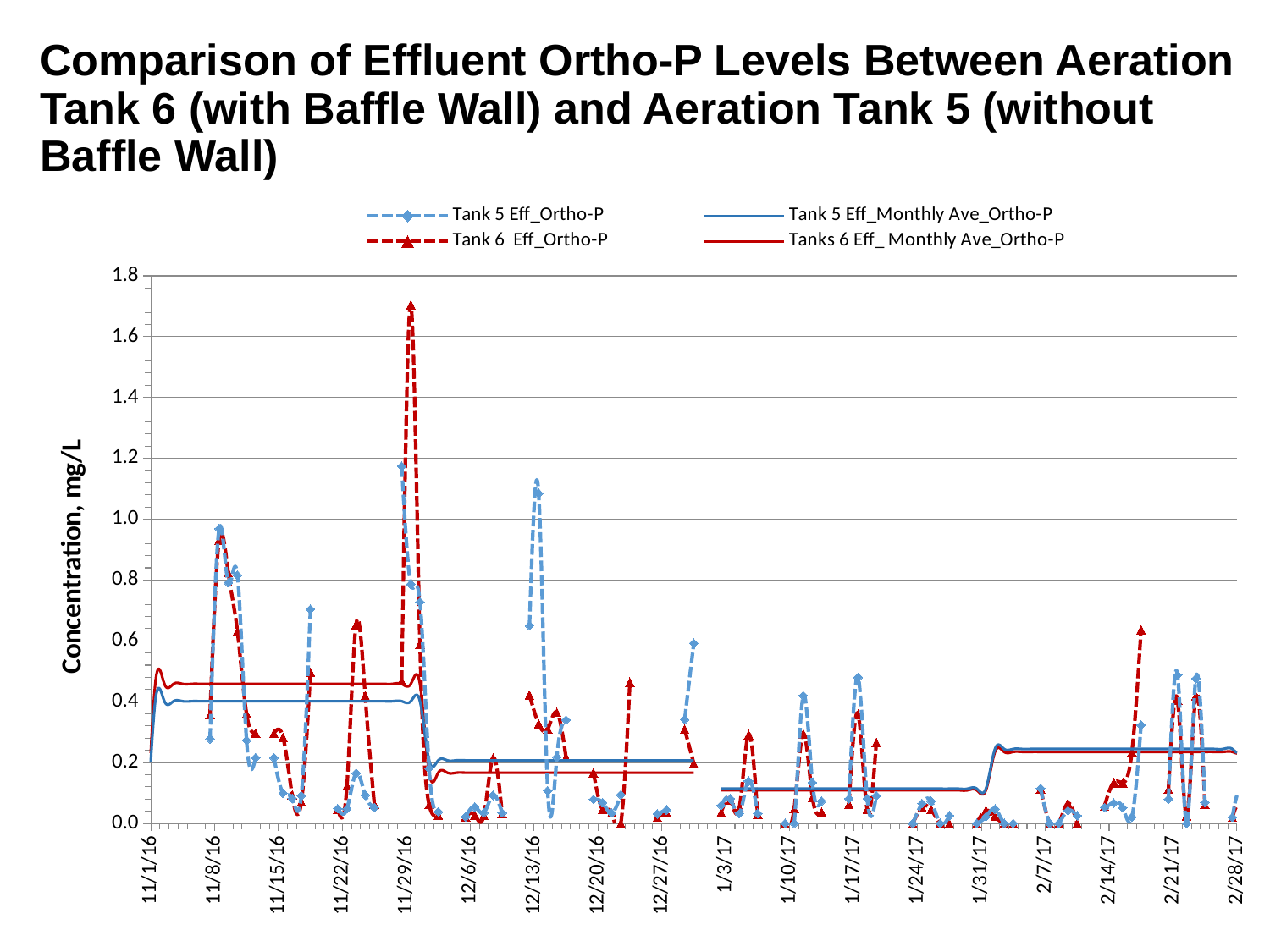
Which series reaches the highest peak on the chart? Tank 6 Eff_Ortho-P Is the Tank 5 Eff_Monthly Ave_Ortho-P value during November 2016 greater or less than 0.2? greater How many series does the legend list? 4 Is the highest Tank 5 Eff_Ortho-P value, near 12/13/16, greater or less than 1.0? greater Is the Tanks 6 Eff_ Monthly Ave_Ortho-P value during December 2016 greater or less than 0.2? less What is the title of the vertical axis? Concentration, mg/L Do the monthly average lines rise or fall from November 2016 to January 2017? fall What is the first date label on the horizontal axis? 11/1/16 What kind of chart is shown on the slide? line chart During November 2016, which monthly average line is higher, Tank 5 or Tank 6? Tank 6